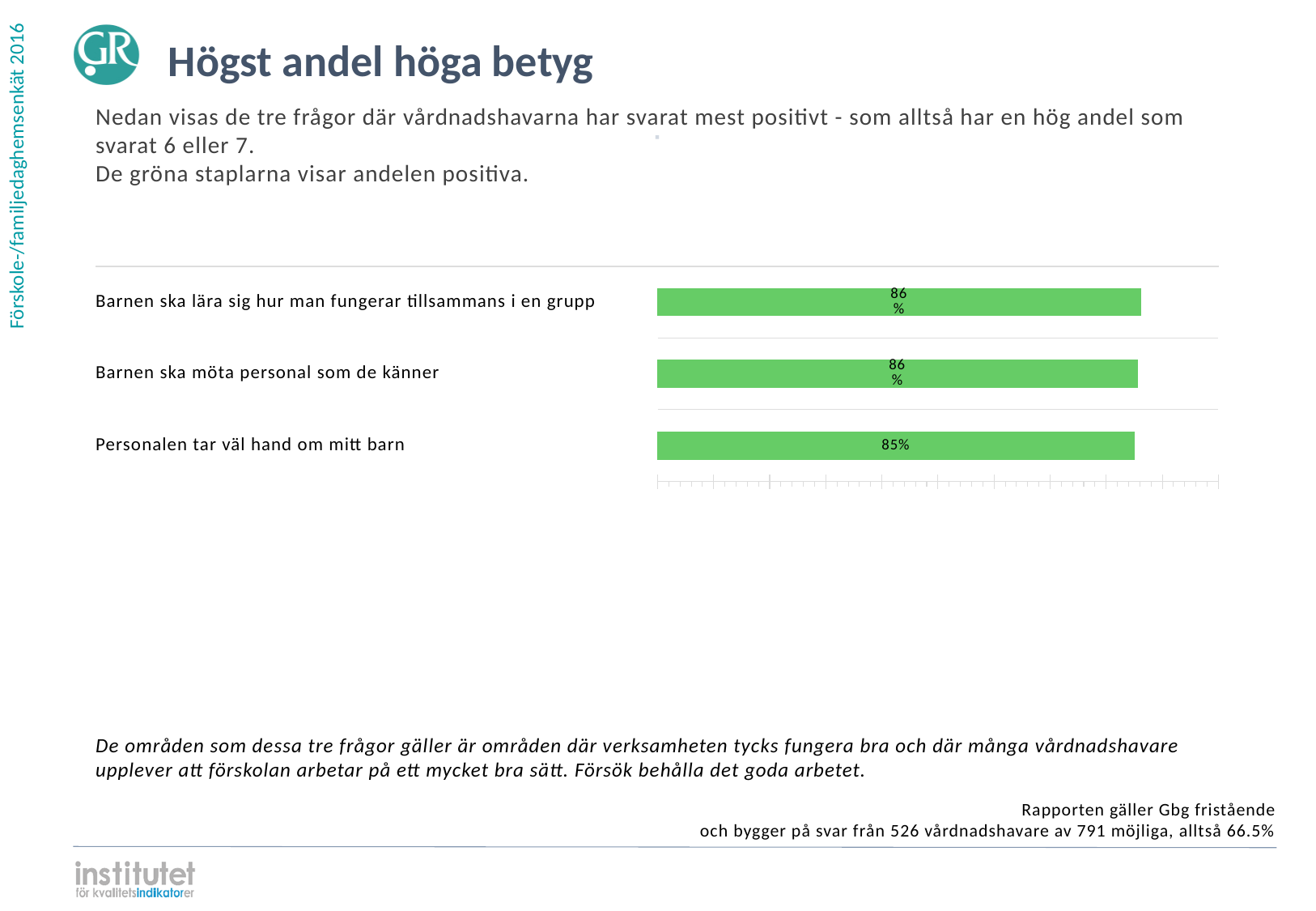
Which category has the lowest value? Personalen tar väl hand om mitt barn What is the difference between the value for "Barnen ska lära sig hur man fungerar tillsammans i en grupp" and the value for "Personalen tar väl hand om mitt barn"? 1% What kind of chart is shown on the slide? Bar chart What colour are the bars in the chart? Green Which is larger: the value for "Barnen ska möta personal som de känner" or the value for "Personalen tar väl hand om mitt barn"? Barnen ska möta personal som de känner Do "Barnen ska lära sig hur man fungerar tillsammans i en grupp" and "Barnen ska möta personal som de känner" have the same value? Yes, both 86% How many categories are shown in the chart? 3 What is the value for "Personalen tar väl hand om mitt barn"? 85% What is the value for "Barnen ska lära sig hur man fungerar tillsammans i en grupp"? 86% What is the value for "Barnen ska möta personal som de känner"? 86% What is the title of the slide containing the chart? Högst andel höga betyg